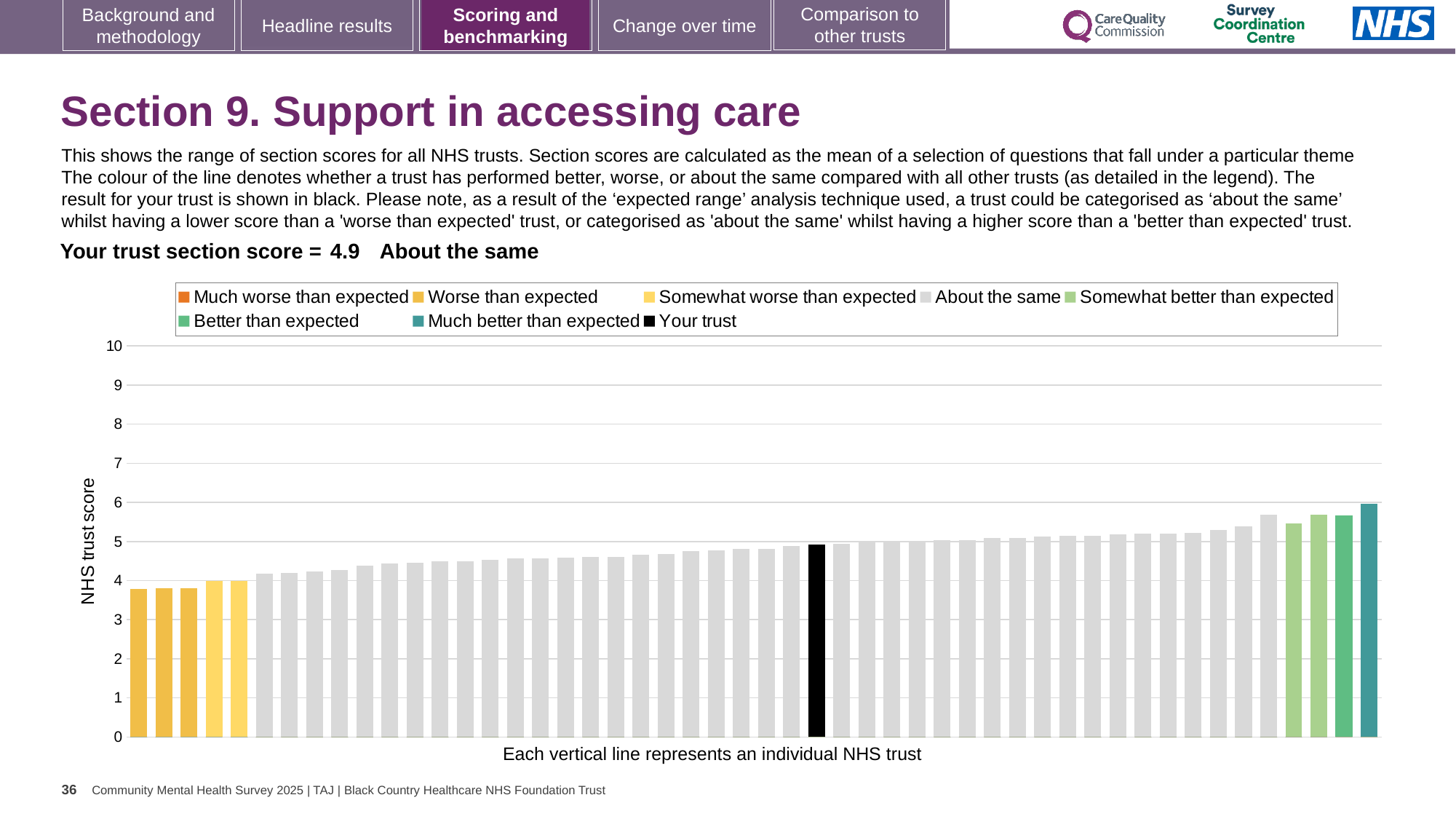
Which legend category is represented by the black bar? Your trust How many bars are coloured as 'Much better than expected'? 1 Is the value of the black 'Your trust' bar greater or less than 5? less What is the section score for your trust (the black bar)? 4.9 How many entries does the chart legend list? 8 What kind of chart is shown on the slide? Bar chart Is the value of the tallest bar greater or less than 5? greater How many bars are coloured as 'Worse than expected' (the darker yellow)? 3 Do the bar values rise or fall from left to right along the x axis? Rise What is the label on the vertical axis of the chart? NHS trust score Is the value of the leftmost bar greater or less than 4? less